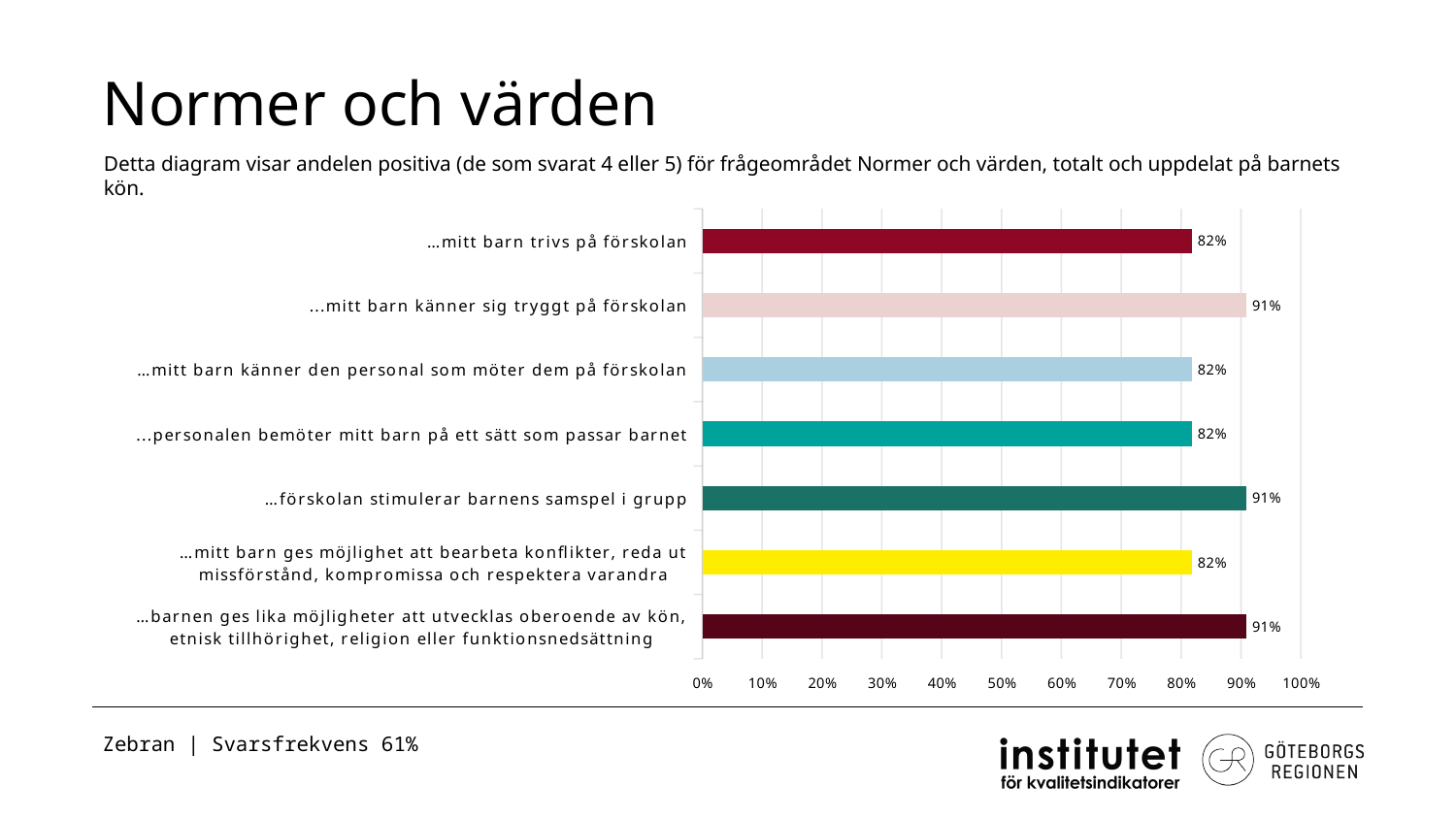
What is the highest tick value shown on the horizontal axis? 100% What is the lowest value shown in the chart? 82% What is the difference between the value for "...mitt barn känner sig tryggt på förskolan" and the value for "…mitt barn trivs på förskolan"? 9 percentage points What is the value for "…mitt barn ges möjlighet att bearbeta konflikter, reda ut missförstånd, kompromissa och respektera varandra"? 82% What is the value for "…mitt barn trivs på förskolan"? 82% What is the value for "…förskolan stimulerar barnens samspel i grupp"? 91% What kind of chart is shown on the slide? Bar chart Is the value for "...personalen bemöter mitt barn på ett sätt som passar barnet" greater or less than 90%? less Which has the larger value: "…mitt barn känner den personal som möter dem på förskolan" or "…barnen ges lika möjligheter att utvecklas oberoende av kön, etnisk tillhörighet, religion eller funktionsnedsättning"? …barnen ges lika möjligheter att utvecklas oberoende av kön, etnisk tillhörighet, religion eller funktionsnedsättning What is the highest value shown in the chart? 91% What is the value for "...mitt barn känner sig tryggt på förskolan"? 91% How many categories (bars) does the chart show? 7